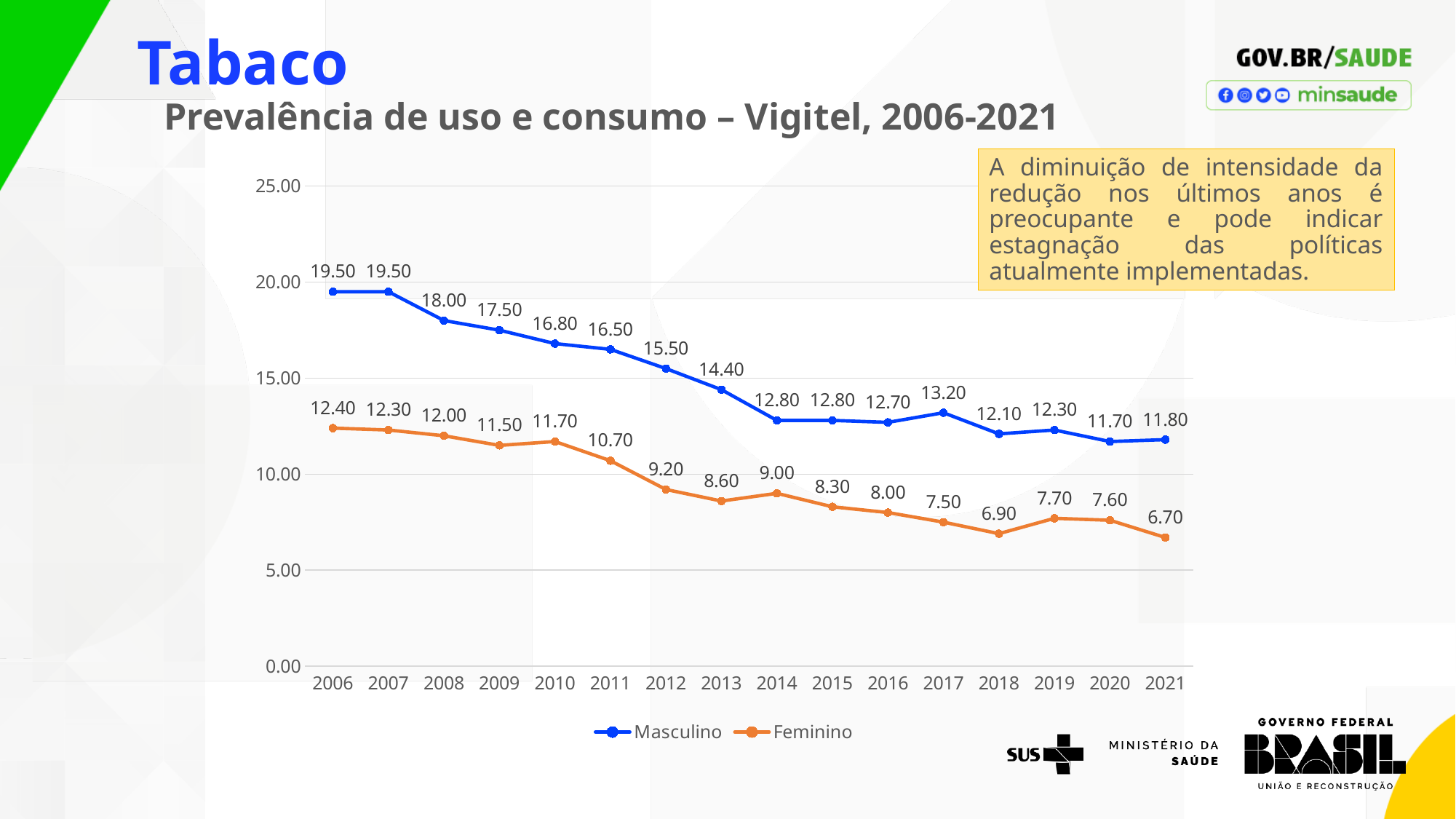
What is the difference between the Masculino and Feminino values in 2021? 5.10 Does the Masculino series generally rise or fall from 2006 to 2021? Fall What is the value for Masculino in 2006? 19.50 What is the value for Feminino in 2021? 6.70 What kind of chart is shown on the slide? Line chart What is the value for Masculino in 2017? 13.20 How many years are shown on the x axis? 16 In which year is the Masculino series highest? 2006 and 2007 What is the value for Feminino in 2014? 9.00 In which year is the Feminino series lowest? 2021 How many series does the legend list? 2 Which series has the larger value in 2012, Masculino or Feminino? Masculino